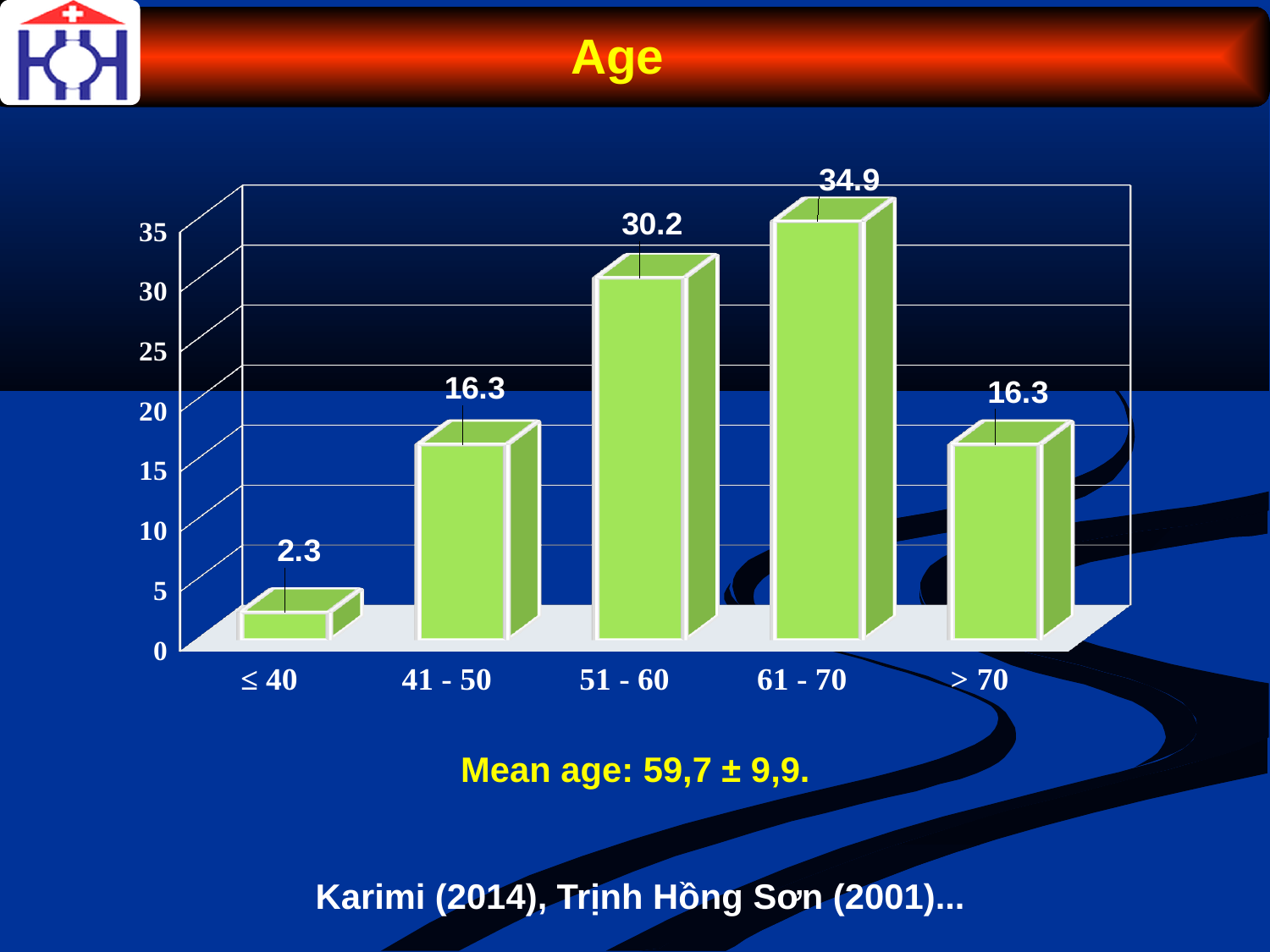
What is the value for the 51 - 60 age group? 30.2 What kind of chart is shown on the slide? bar chart What is the difference between the values for the 61 - 70 and 51 - 60 age groups? 4.7 Which age group has the highest value? 61 - 70 Is the value for the 61 - 70 age group greater or less than 30? greater What is the value for the ≤ 40 age group? 2.3 How many age groups are shown on the chart? 5 Which is larger, the value for 51 - 60 or the value for > 70? 51 - 60 What is the value for the > 70 age group? 16.3 What is the difference between the values for the 41 - 50 and ≤ 40 age groups? 14 What is the title of the chart? Age Which age group has the lowest value? ≤ 40